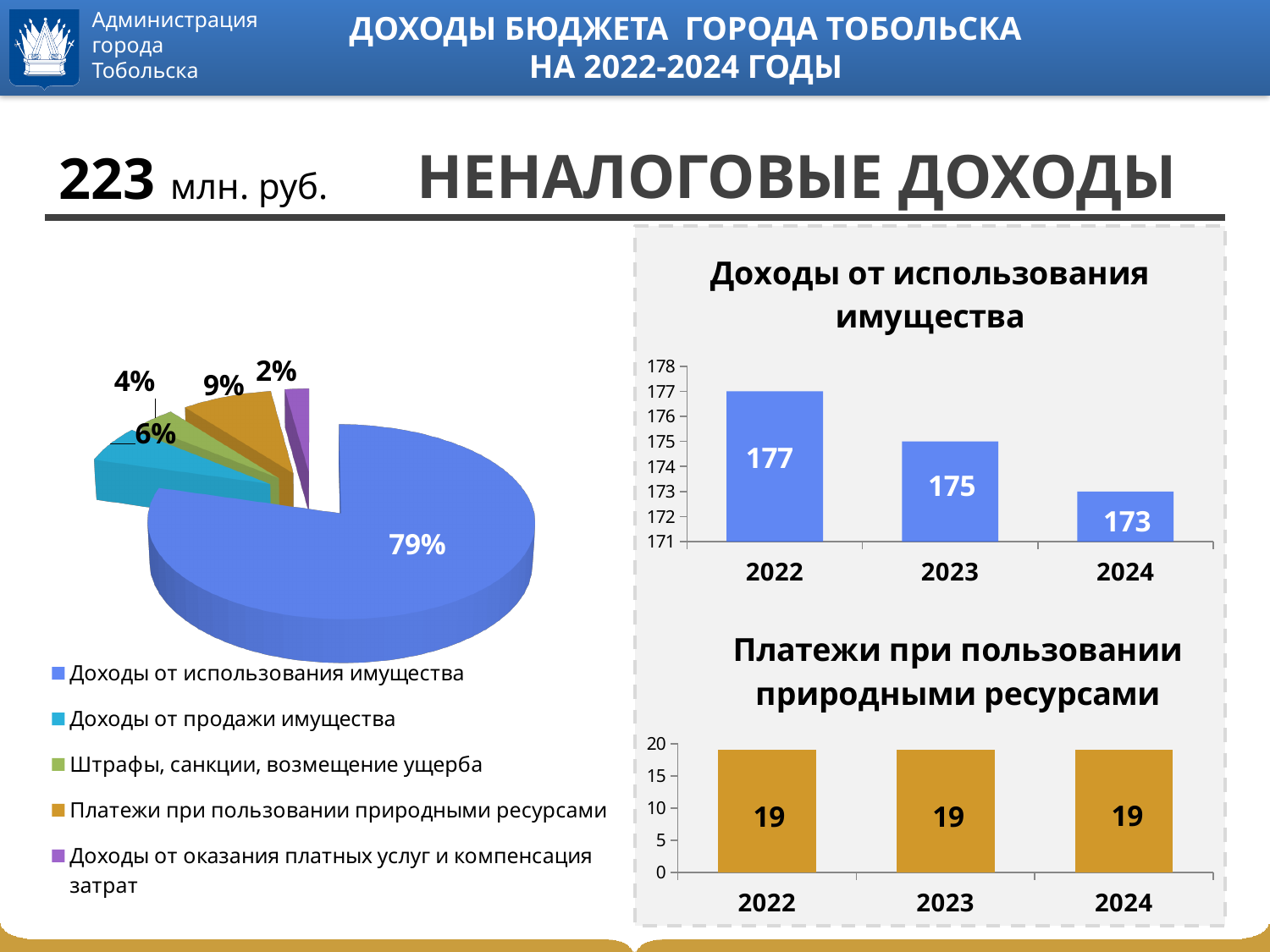
In the chart 'Доходы от использования имущества', which year has the highest value? 2022 In the pie chart on the left, what share does 'Доходы от использования имущества' have? 79% In the chart 'Доходы от использования имущества', do the values rise or fall from 2022 to 2024? fall In the pie chart on the left, what share does 'Доходы от оказания платных услуг и компенсация затрат' have? 2% In the chart 'Доходы от использования имущества', what is the value for 2023? 175 In the pie chart on the left, which category has the smallest share? Доходы от оказания платных услуг и компенсация затрат What kind of chart is 'Платежи при пользовании природными ресурсами'? bar chart How many categories does the legend of the pie chart on the left list? 5 In the pie chart on the left, which category has the largest share? Доходы от использования имущества In the chart 'Доходы от использования имущества', what is the difference between the values for 2022 and 2024? 4 In the chart 'Платежи при пользовании природными ресурсами', what is the value for 2024? 19 In the pie chart on the left, what share does 'Платежи при пользовании природными ресурсами' have? 9%